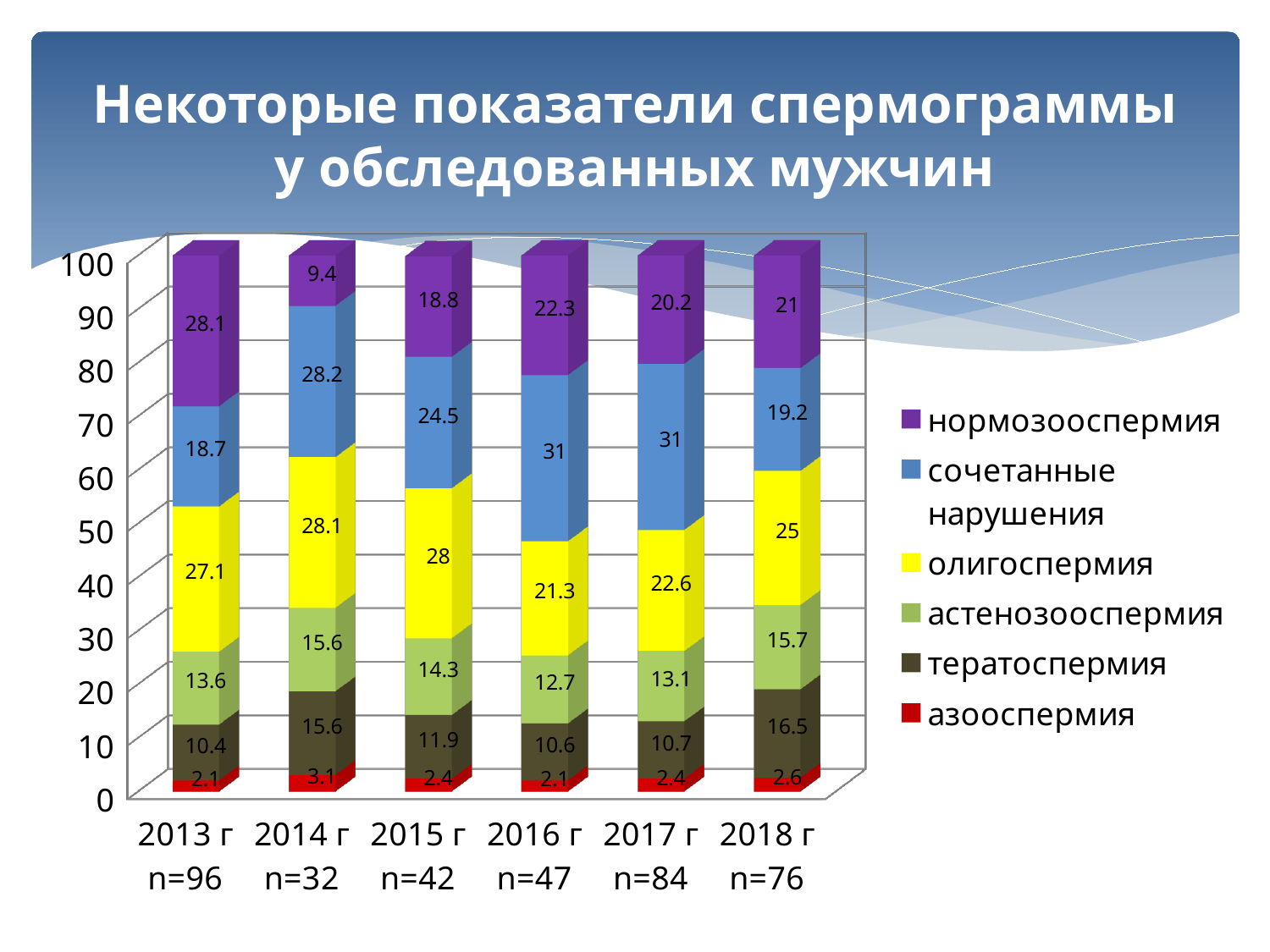
How many year categories are shown on the x axis? 6 What is the value for азооспермия in 2014 г? 3.1 What is the difference between the нормозооспермия values for 2013 г and 2014 г? 18.7 What is the value for сочетанные нарушения in 2016 г? 31 What type of chart is shown on the slide? stacked bar chart What is the sample size (n) shown for 2017 г? n=84 In which year is the value for нормозооспермия the lowest? 2014 г What is the value for нормозооспермия in 2013 г? 28.1 How many series does the legend list? 6 What is the value for олигоспермия in 2018 г? 25 In which year is the value for тератоспермия the highest? 2018 г Which is larger: the олигоспермия value in 2015 г or in 2016 г? 2015 г